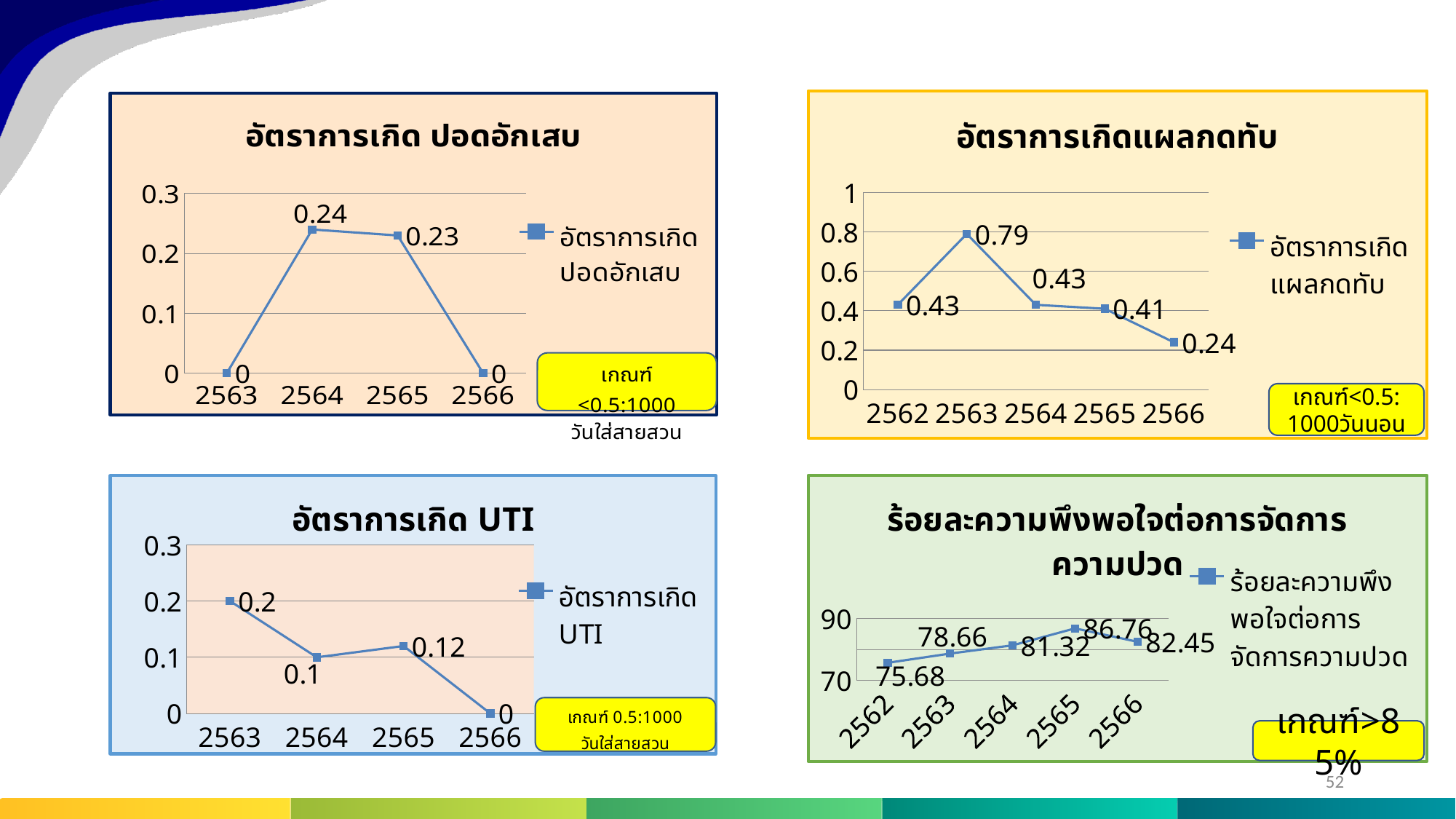
What type of chart is the bottom-right chart titled "ร้อยละความพึงพอใจต่อการจัดการความปวด"? Line chart In the bottom-left chart titled "อัตราการเกิด UTI", what is the value for 2563? 0.2 In the bottom-left chart titled "อัตราการเกิด UTI", which is larger, the value for 2564 or the value for 2565? 2565 In the top-right chart titled "อัตราการเกิดแผลกดทับ", what is the difference between the values for 2563 and 2564? 0.36 In the top-right chart titled "อัตราการเกิดแผลกดทับ", which year has the highest value? 2563 How many series does the legend of the top-left chart titled "อัตราการเกิด ปอดอักเสบ" list? 1 In the bottom-right chart titled "ร้อยละความพึงพอใจต่อการจัดการความปวด", which year has the lowest value? 2562 In the top-right chart titled "อัตราการเกิดแผลกดทับ", what is the value for 2566? 0.24 How many data points are plotted in the top-right chart titled "อัตราการเกิดแผลกดทับ"? 5 In the top-left chart titled "อัตราการเกิด ปอดอักเสบ", what is the value for 2565? 0.23 In the bottom-right chart titled "ร้อยละความพึงพอใจต่อการจัดการความปวด", what is the value for 2565? 86.76 In the top-left chart titled "อัตราการเกิด ปอดอักเสบ", what is the value for 2564? 0.24